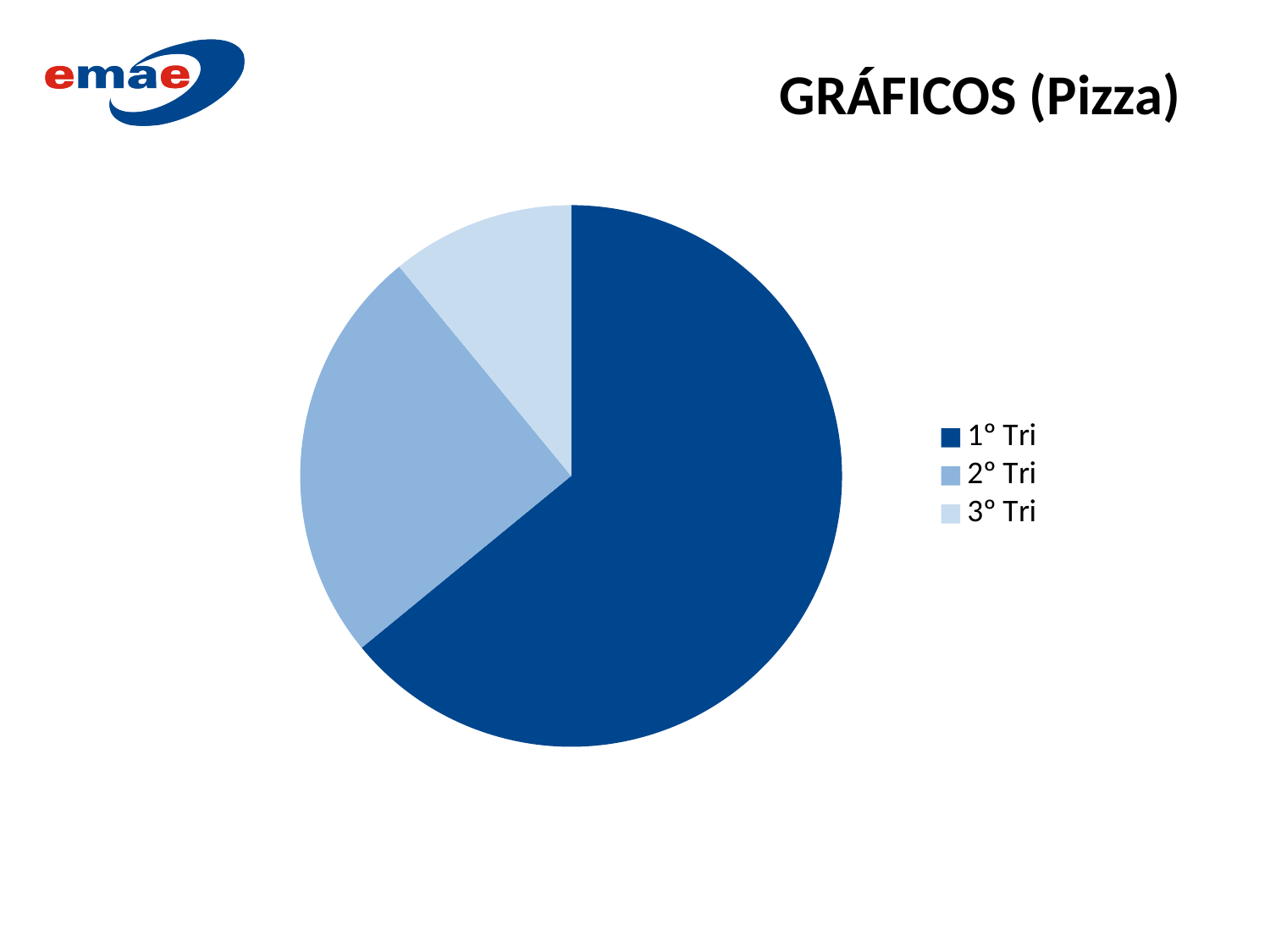
Which legend entry is shown in the darkest blue? 1° Tri Which category has the largest slice of the pie? 1° Tri How many entries does the legend list? 3 Which category has the smallest slice of the pie? 3° Tri Does the 1° Tri slice take up more or less than half of the pie? more How many slices does the pie chart have? 3 What is the title shown on the slide above the chart? GRÁFICOS (Pizza) Which slice is larger, 1° Tri or 2° Tri? 1° Tri What kind of chart is shown on the slide? Pie chart Which slice is larger, 2° Tri or 3° Tri? 2° Tri